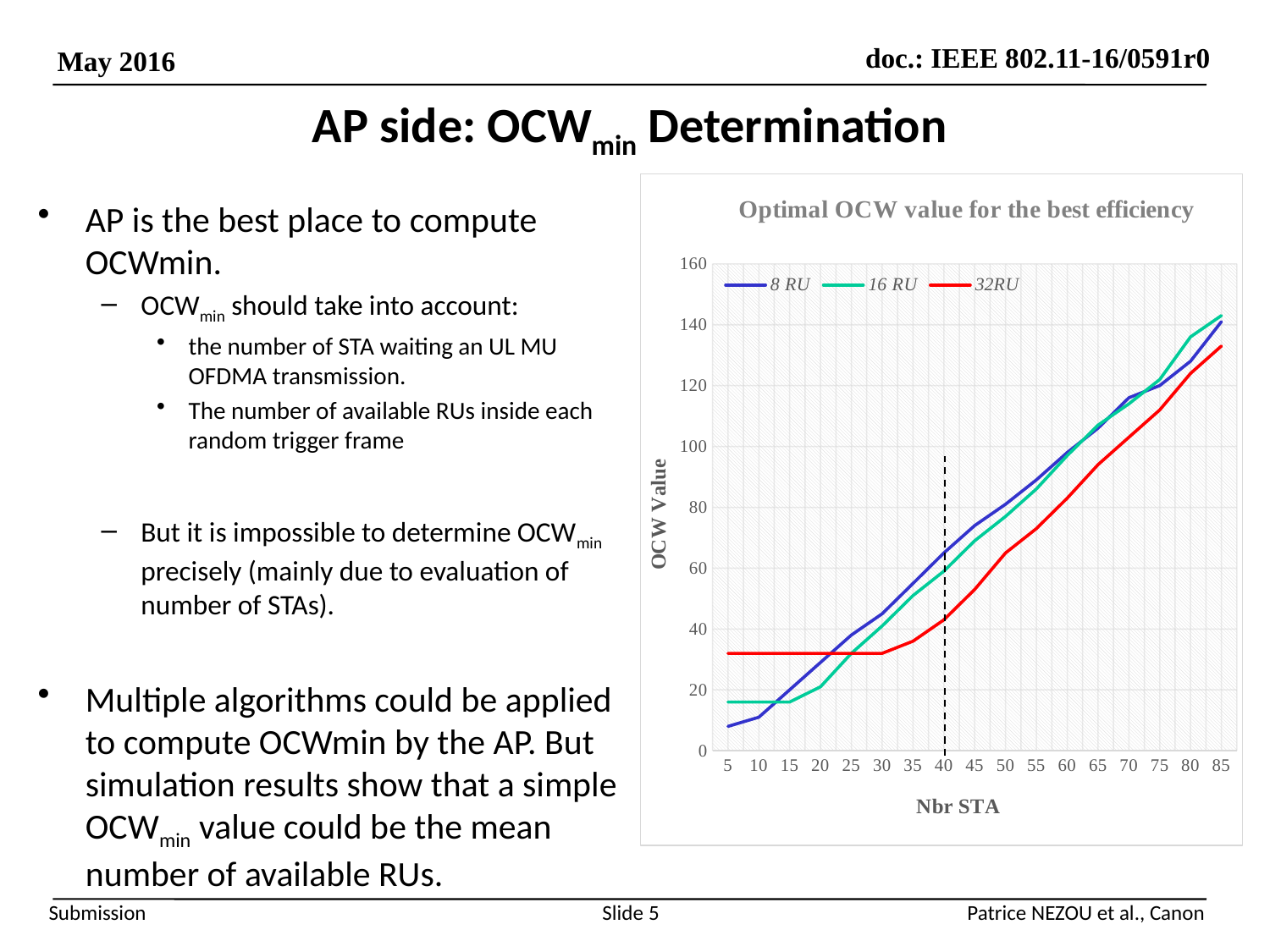
What is the label of the y axis of the chart? OCW Value How many Nbr STA values are marked along the x axis of the chart? 17 Is the value of the 32RU series at 85 STA greater or less than 140? less Is the value of the 32RU series at 45 STA greater or less than 60? less Does the 8 RU series rise or fall as Nbr STA increases? rise What is the title of the chart? Optimal OCW value for the best efficiency At 5 STA, which series has the larger value, 8 RU or 32RU? 32RU How many series does the chart legend list? 3 What kind of chart is shown on the slide? line chart Is the value of the 16 RU series at 85 STA greater or less than 140? greater